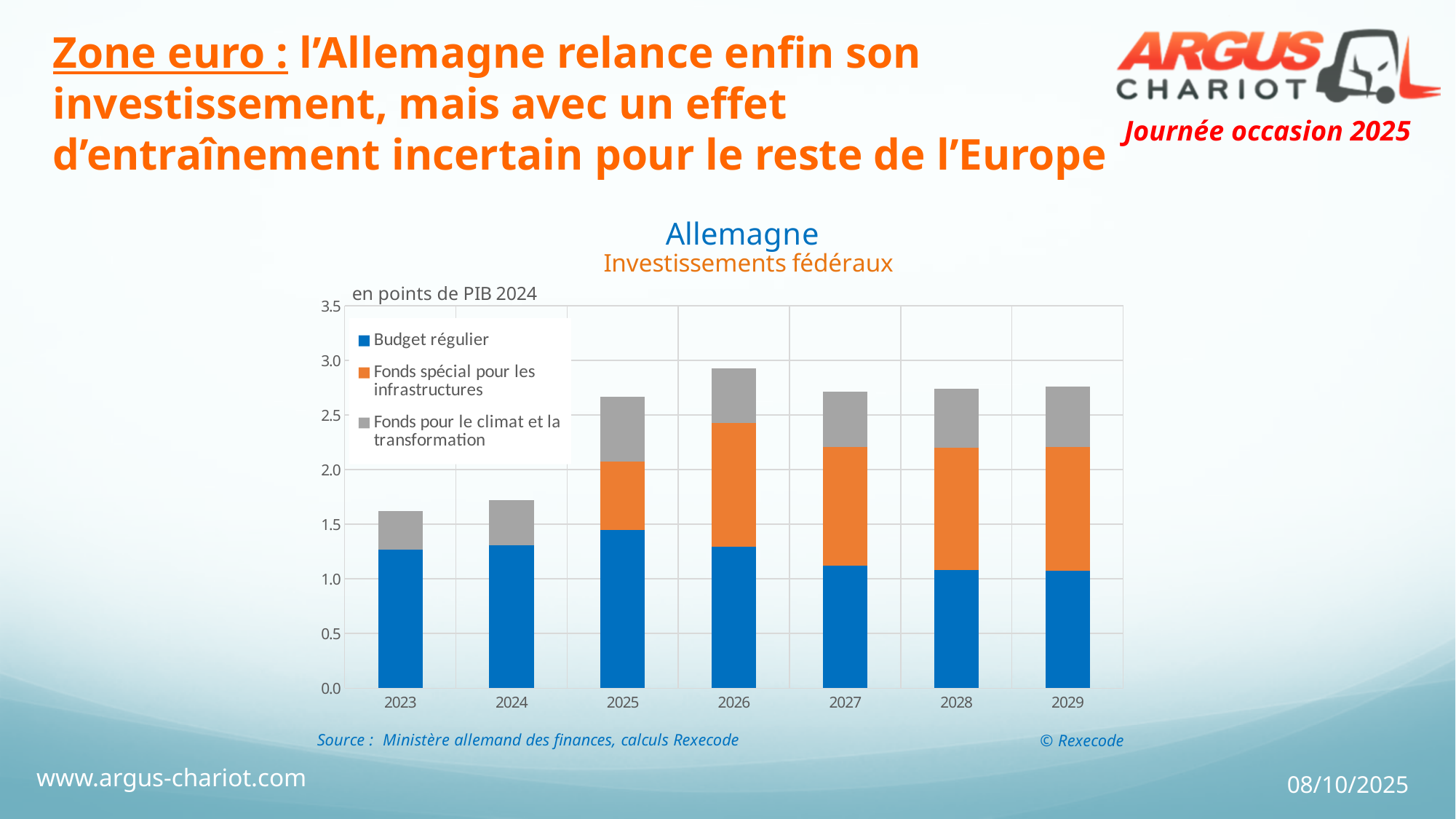
How many years are shown on the x axis of the chart? 7 What kind of chart is shown on the slide? Stacked bar chart Do the total values rise or fall from 2023 to 2026? rise In what unit are the values of the chart expressed, according to the label above the axis? en points de PIB 2024 Which year has the highest total federal investment in the chart? 2026 Is the total value for 2023 greater or less than 2.0? less Is the total value for 2026 greater or less than 2.5? greater Is the 'Budget régulier' value for 2025 greater or less than 1.0? greater Which year has the lowest total federal investment in the chart? 2023 Which year has the larger total federal investment, 2024 or 2025? 2025 How many series does the chart legend list? 3